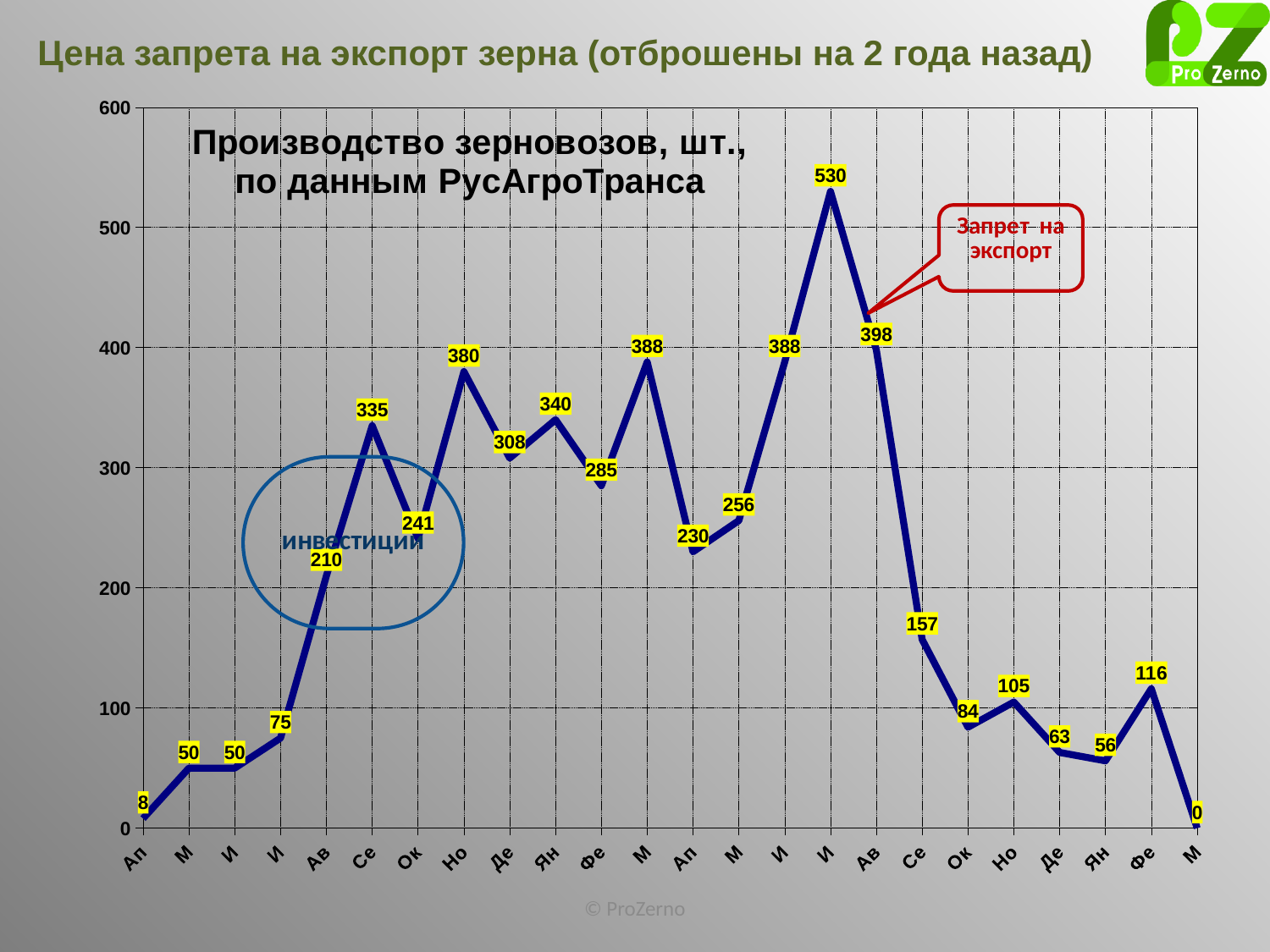
How many data points are plotted on the chart? 24 What is the difference between the peak value 530 and the following point 398? 132 What is the lowest value plotted on the chart? 0 Do the values rise or fall over the last eight points of the chart, from 530 to 0? fall Is the value of the point labelled 157 greater or less than 200? less What is the title of the chart? Производство зерновозов, шт., по данным РусАгроТранса What is the highest value plotted on the chart? 530 Which is larger: the value 380 at the first Но or the value 105 at the second Но? 380 What kind of chart is shown on the slide? line chart What is the value of the point marked with the callout 'Запрет на экспорт'? 398 What is the value of the last data point (М) on the chart? 0 What is the value of the first data point (Ап) on the chart? 8